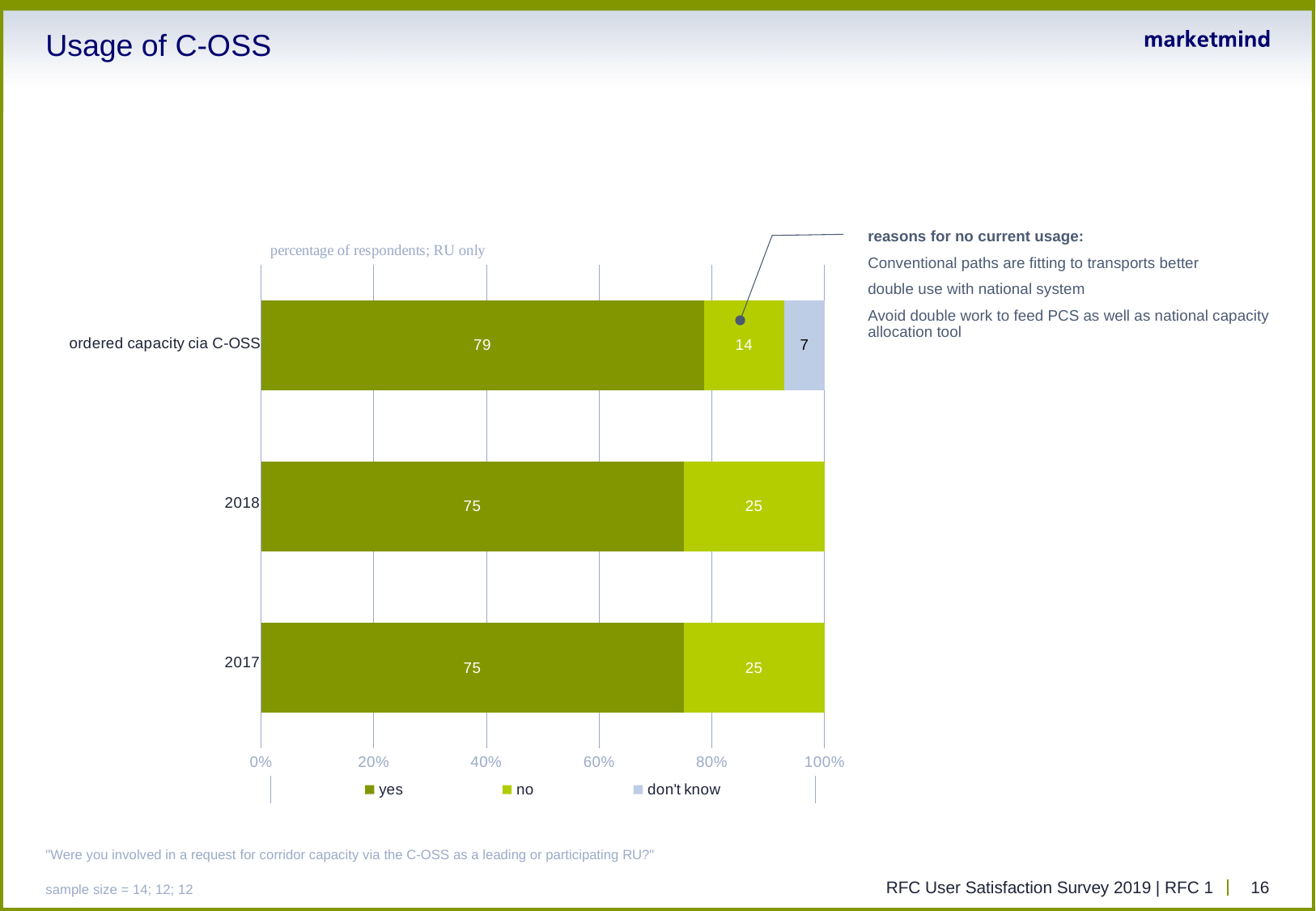
What is the 'yes' value for 'ordered capacity cia C-OSS'? 79 What is the total of the stacked bar for 'ordered capacity cia C-OSS'? 100 Which is larger: the 'no' value for 2017 or the 'no' value for 'ordered capacity cia C-OSS'? 2017 What is the 'don't know' value for 'ordered capacity cia C-OSS'? 7 Which category has the lowest 'no' value? ordered capacity cia C-OSS How many categories are shown on the chart? 3 Which category has the highest 'yes' value? ordered capacity cia C-OSS What is the difference between the 'yes' value for 'ordered capacity cia C-OSS' and the 'yes' value for 2018? 4 What is the 'yes' value for 2017? 75 How many series does the legend list? 3 What kind of chart is shown on the slide? stacked bar chart What is the 'no' value for 2018? 25